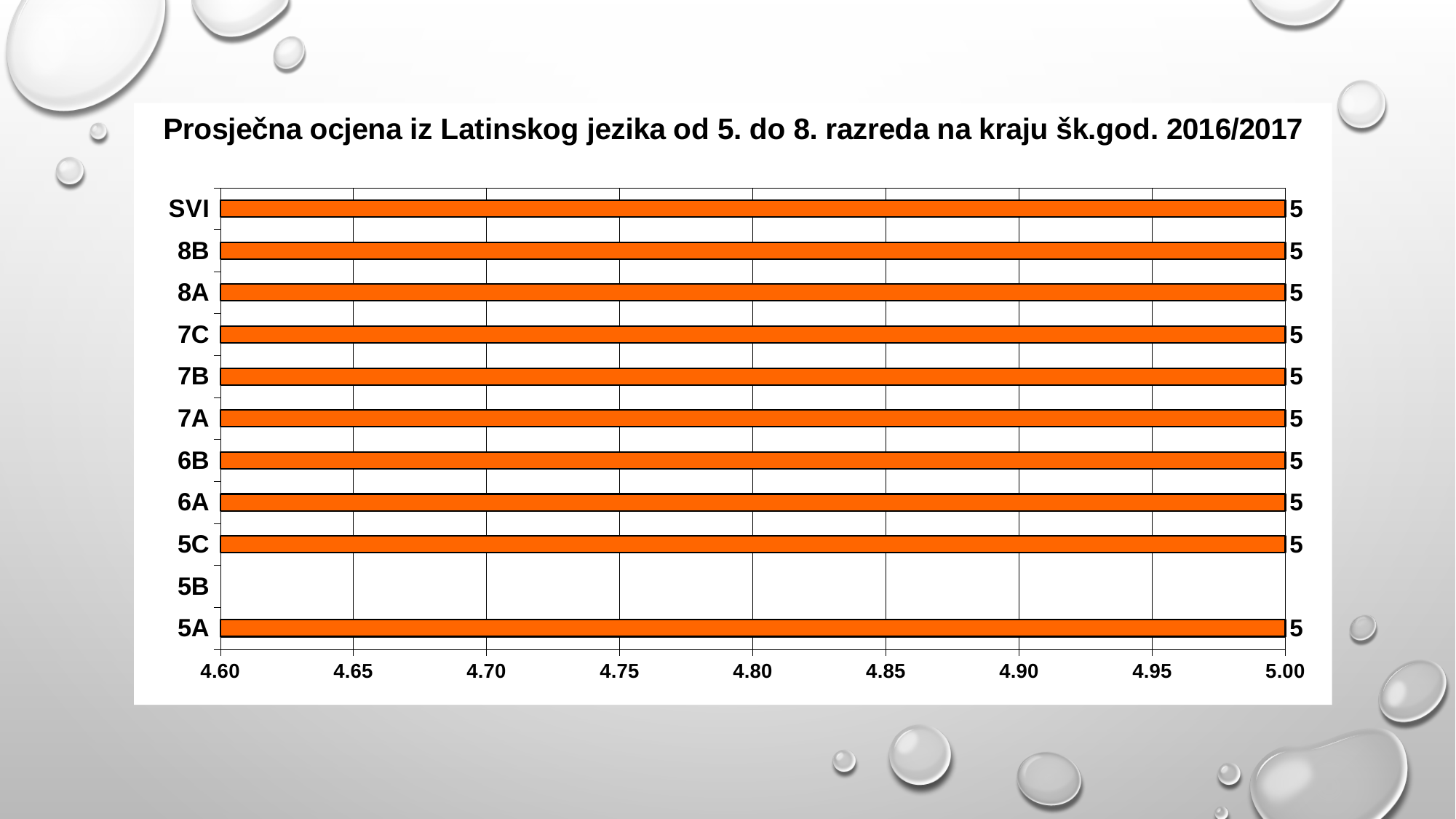
What is the title of the chart? Prosječna ocjena iz Latinskog jezika od 5. do 8. razreda na kraju šk.god. 2016/2017 What is the difference between the values for 6A and 8A? 0 What is the value for SVI? 5 What is the lowest value shown on the horizontal axis? 4.60 What is the value for 5A? 5 What is the value for 8B? 5 Which category has no bar plotted? 5B How many bars are plotted in the chart? 10 Is the value for 7B greater or less than 4.80? greater What kind of chart is shown? bar chart What is the value for 7C? 5 How many categories are listed on the vertical axis? 11